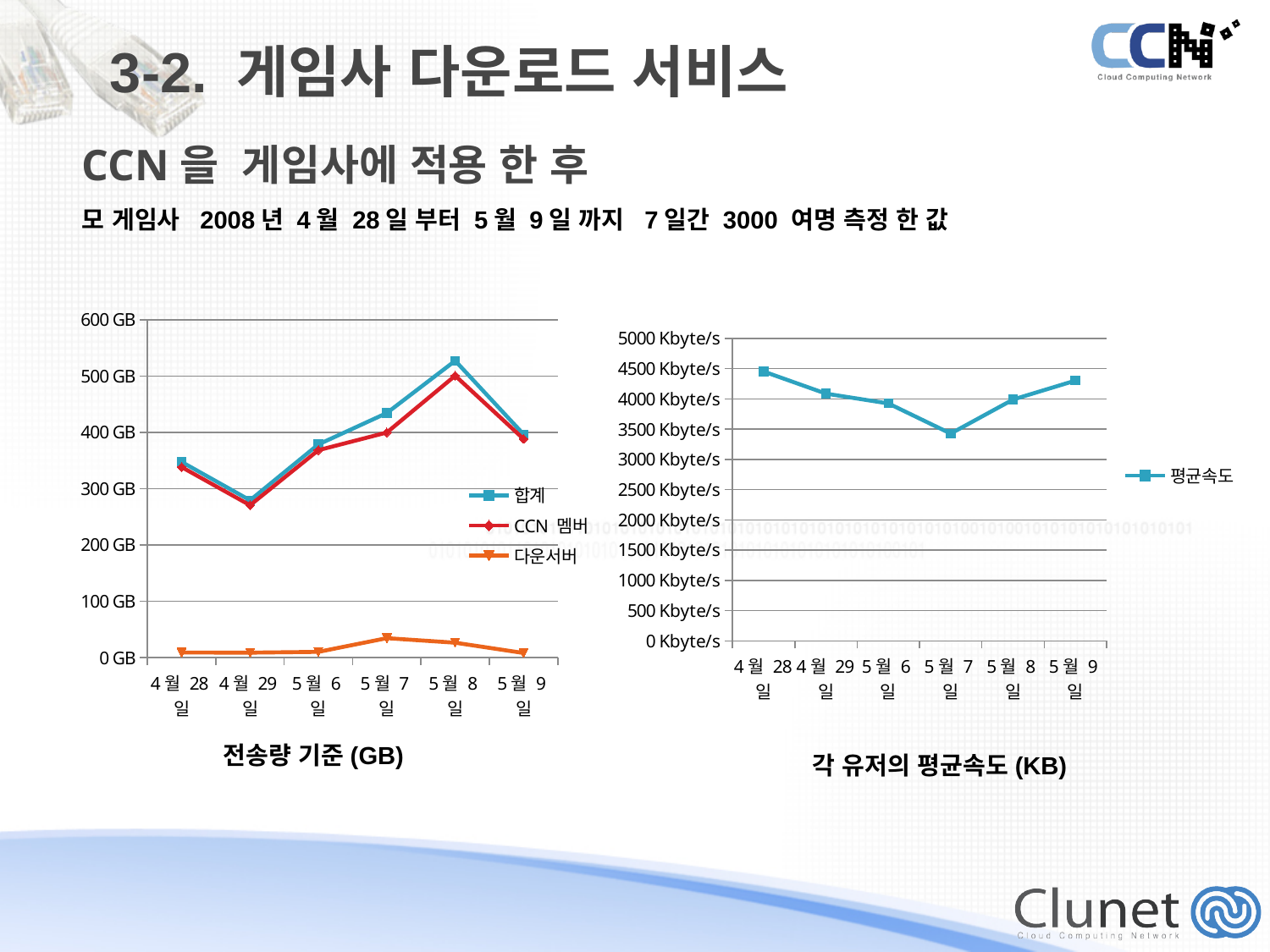
In the right chart 각 유저의 평균속도 (KB), does the 평균속도 rise or fall from 4월 28일 to 5월 7일? fall How many series does the legend of the left chart 전송량 기준 (GB) list? 3 In the right chart 각 유저의 평균속도 (KB), on which date is the 평균속도 highest? 4월 28일 In the left chart 전송량 기준 (GB), on which date does the 합계 series reach its highest value? 5월 8일 What kind of chart is the left chart titled 전송량 기준 (GB)? line chart What is the name of the only series in the legend of the right chart 각 유저의 평균속도 (KB)? 평균속도 In the left chart 전송량 기준 (GB), is the 합계 value on 5월 8일 greater or less than 500 GB? greater In the left chart 전송량 기준 (GB), on which date is the 합계 series lowest? 4월 29일 How many dates are shown on the x axis of the right chart 각 유저의 평균속도 (KB)? 6 In the right chart 각 유저의 평균속도 (KB), on which date is the 평균속도 lowest? 5월 7일 In the left chart 전송량 기준 (GB), which series has the larger value on 5월 7일, 합계 or 다운서버? 합계